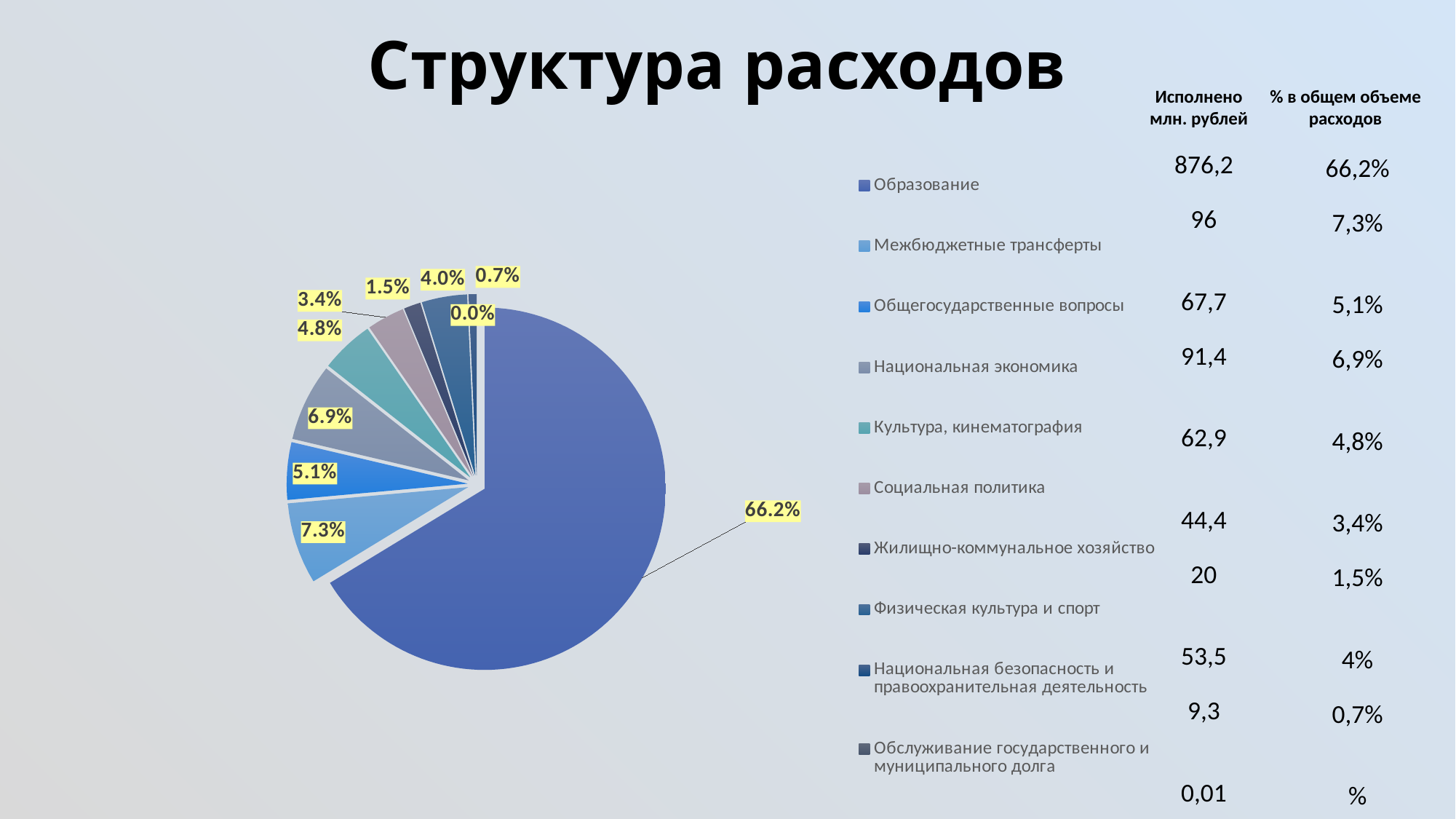
What kind of chart is shown on the slide? pie chart What share of the pie does Межбюджетные трансферты have? 7.3% Which category has the largest slice of the pie? Образование What share of the pie does Физическая культура и спорт have? 4.0% How many categories does the legend list? 10 What is the difference in percentage points between the Образование slice and the Межбюджетные трансферты slice? 58.9 Which slice is larger: Межбюджетные трансферты or Общегосударственные вопросы? Межбюджетные трансферты What is the title of the slide? Структура расходов Which category has the smallest slice of the pie? Обслуживание государственного и муниципального долга What share of the pie does Национальная экономика have? 6.9% What share of the pie does Образование have? 66.2% What share of the pie does Культура, кинематография have? 4.8%